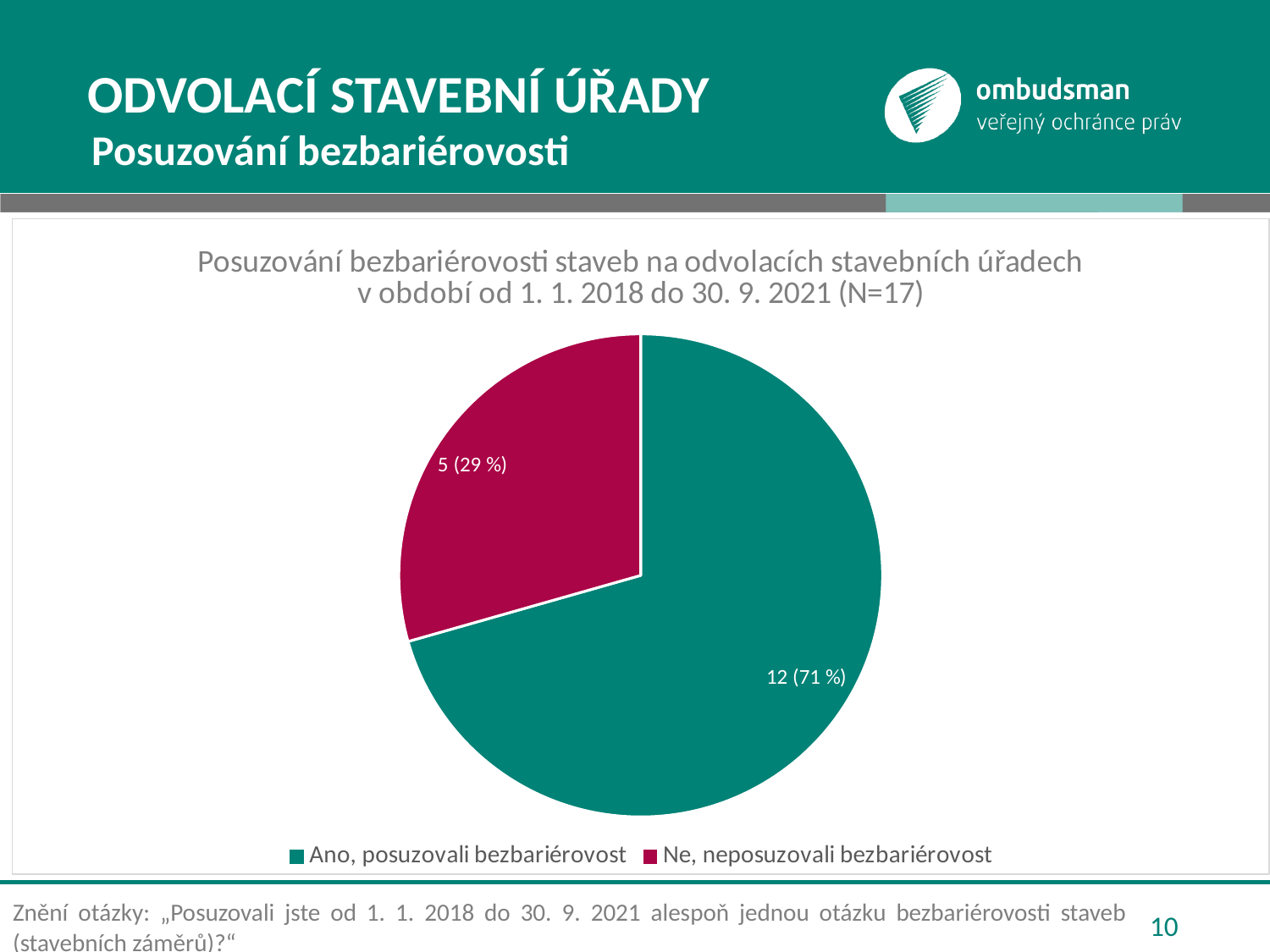
What colour is the slice for "Ne, neposuzovali bezbariérovost"? dark red (magenta) What share of the pie does "Ano, posuzovali bezbariérovost" represent? 71 % What is the data label on the slice for "Ano, posuzovali bezbariérovost"? 12 (71 %) What is the difference in count between "Ano, posuzovali bezbariérovost" and "Ne, neposuzovali bezbariérovost"? 7 What is the data label on the slice for "Ne, neposuzovali bezbariérovost"? 5 (29 %) How many slices does the pie chart have? 2 What is the total number of responses across both slices? 17 What share of the pie does "Ne, neposuzovali bezbariérovost" represent? 29 % Which slice is the largest? Ano, posuzovali bezbariérovost How many entries does the legend list? 2 Which slice is the smallest? Ne, neposuzovali bezbariérovost What kind of chart is shown on the slide? pie chart